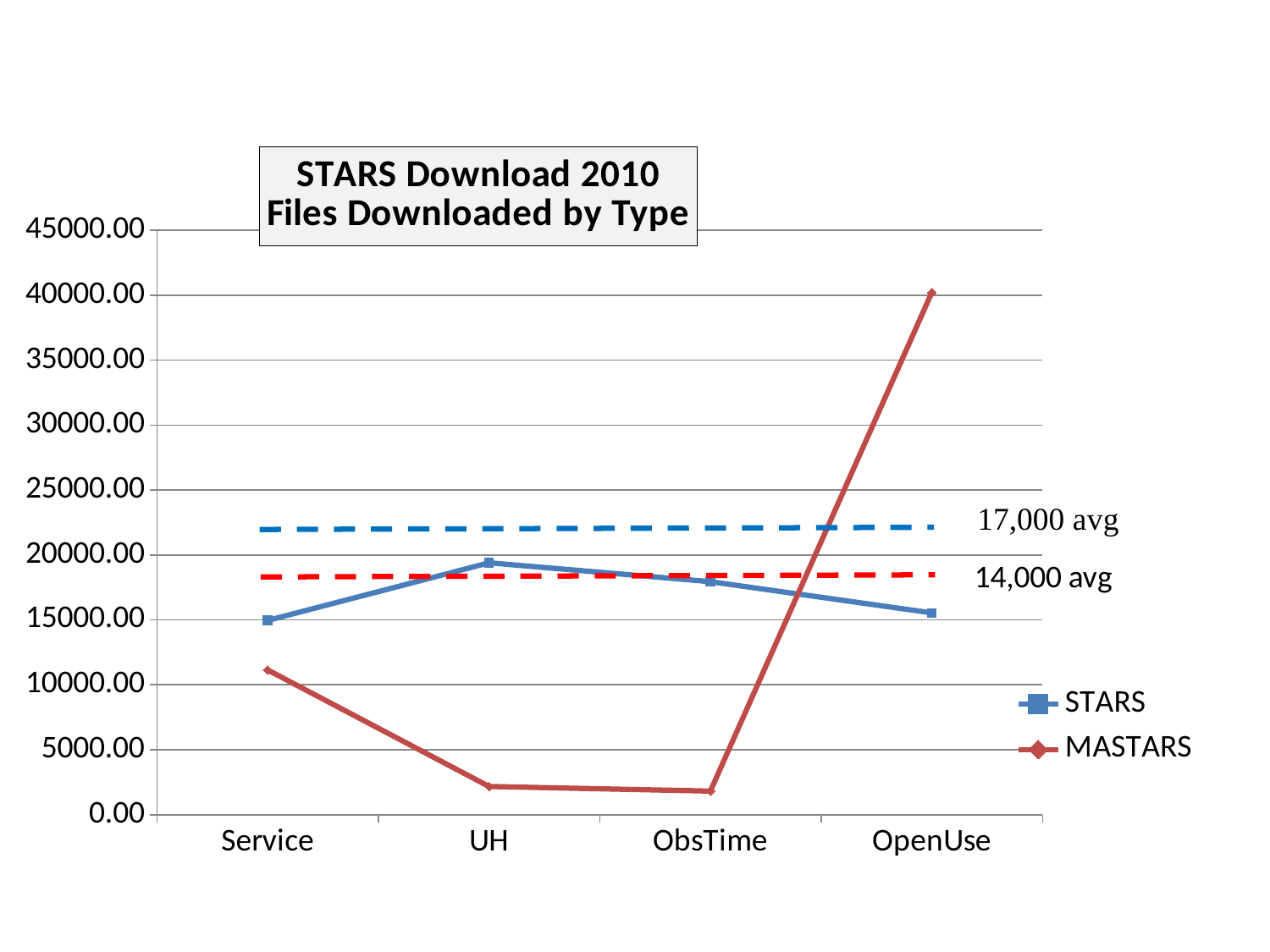
For which category is the MASTARS value highest? OpenUse Is the MASTARS value for UH greater or less than 5000.00? less At UH, which series has the larger value, STARS or MASTARS? STARS Is the MASTARS value for OpenUse greater or less than 35000.00? greater At OpenUse, which series has the larger value, STARS or MASTARS? MASTARS How many categories are shown on the x axis? 4 What is the title of the chart? STARS Download 2010 Files Downloaded by Type What kind of chart is shown on the slide? line chart Is the MASTARS value for Service greater or less than 15000.00? less How many series does the legend list? 2 For which category is the STARS value highest? UH Does the MASTARS line rise or fall from ObsTime to OpenUse? rise